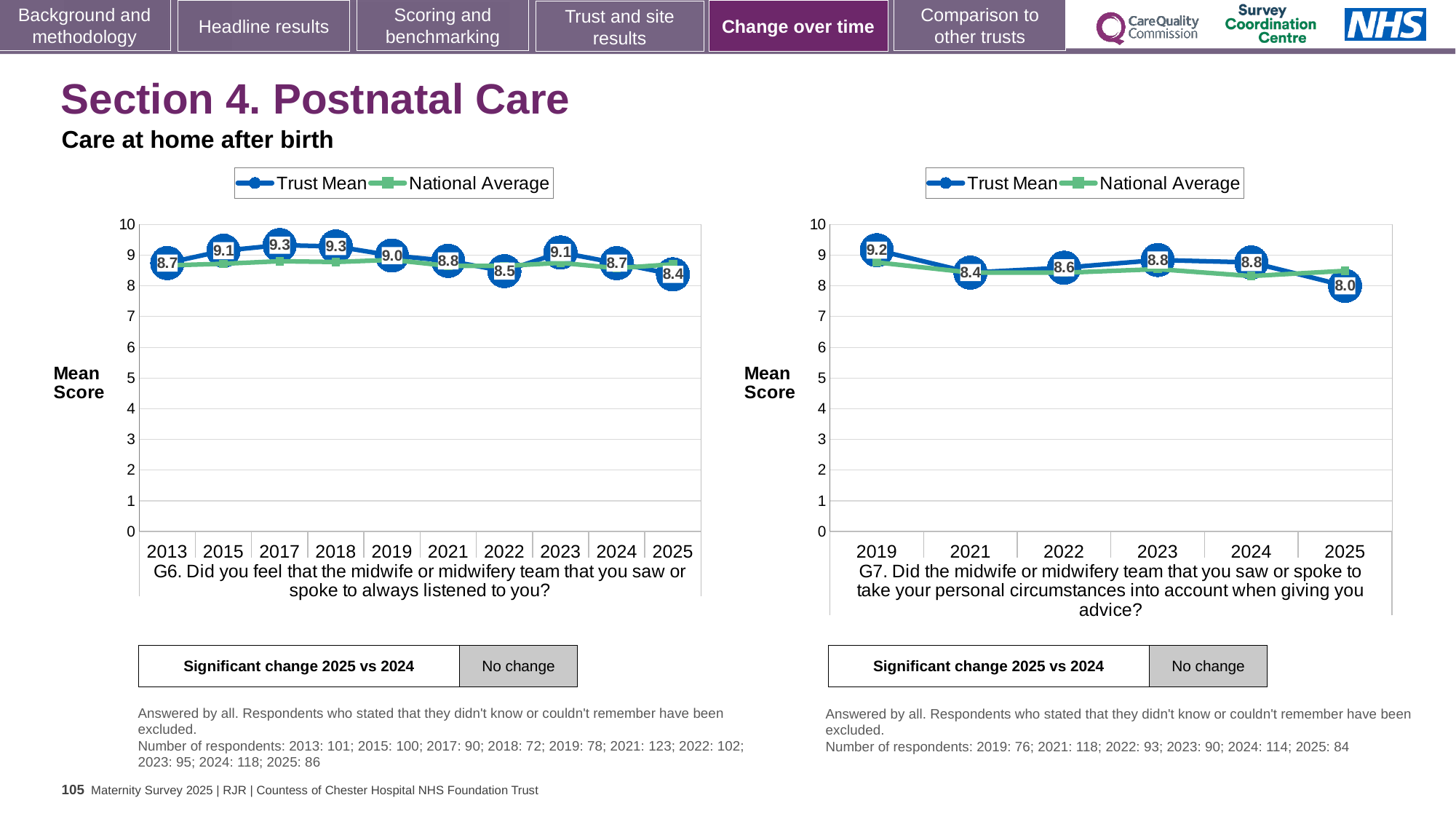
In the right chart (G7), what is the difference between the Trust Mean score in 2019 and in 2025? 1.2 In the right chart (G7), which year has the lowest Trust Mean score? 2025 In the left chart (G6), is the Trust Mean score higher in 2015 or in 2022? 2015 In the left chart (G6), what is the Trust Mean score for 2025? 8.4 In the right chart (G7), which year has the highest Trust Mean score? 2019 What type of chart is used for the right chart (G7)? Line chart In the left chart (G6), which year has the lowest Trust Mean score? 2025 In the left chart (G6), what is the Trust Mean score for 2017? 9.3 In the right chart (G7), what is the Trust Mean score for 2019? 9.2 How many series does the legend of the right chart (G7) list? 2 In the right chart (G7), is the National Average value for 2025 greater or less than 8? greater How many years are plotted on the x axis of the left chart (G6)? 10